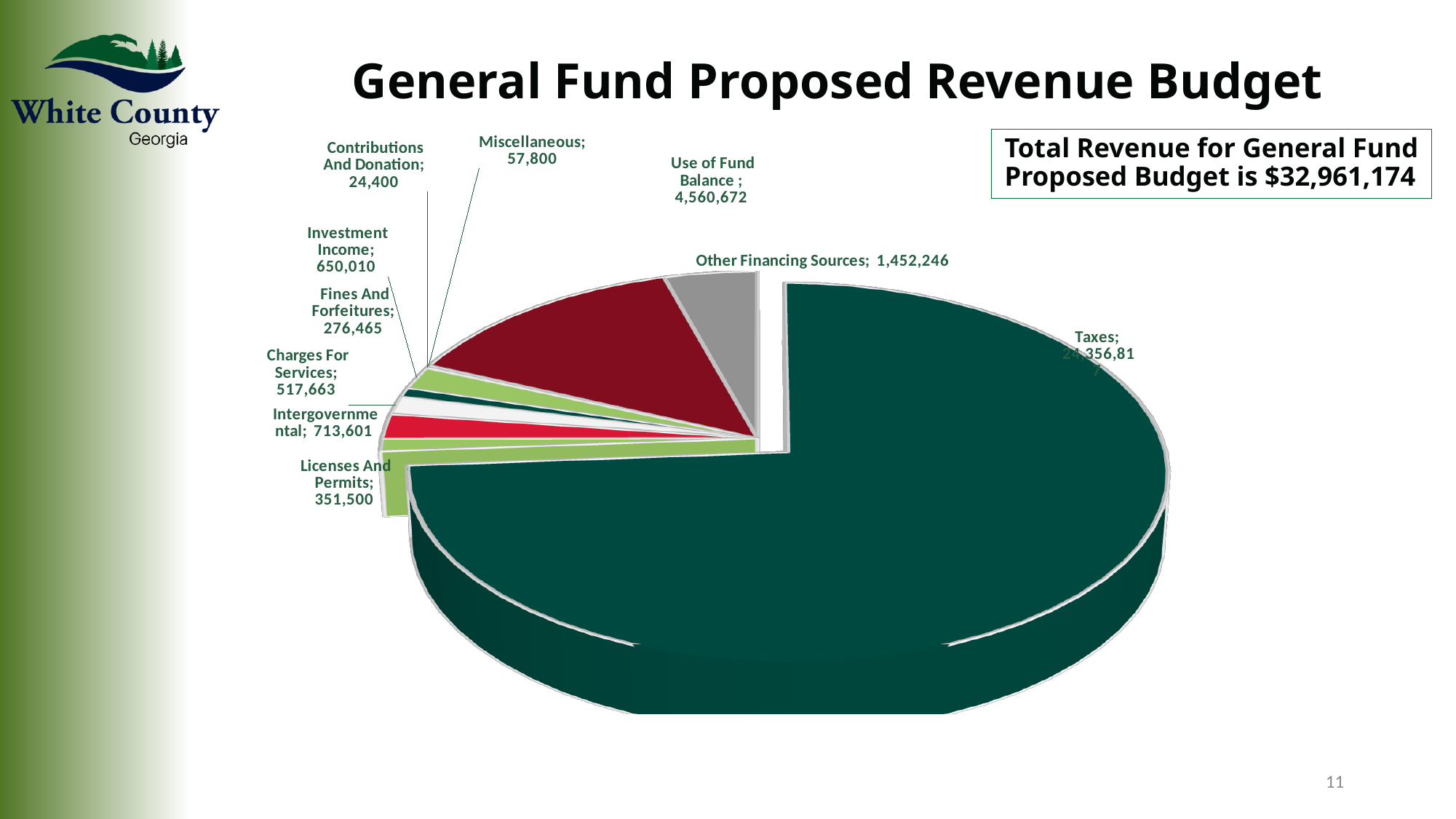
Which is larger, Licenses And Permits or Fines And Forfeitures? Licenses And Permits What is the value shown for Other Financing Sources? 1,452,246 According to the text box on the slide, what is the total revenue for the General Fund Proposed Budget? $32,961,174 What is the value shown for Intergovernmental? 713,601 Which revenue category is the largest slice of the pie chart? Taxes What type of chart is shown on the slide? Pie chart How many revenue categories are shown in the pie chart? 10 Which revenue category is the smallest slice of the pie chart? Contributions And Donation What is the difference between Use of Fund Balance and Other Financing Sources? 3,108,426 What is the value shown for Miscellaneous? 57,800 What is the value shown for Use of Fund Balance? 4,560,672 What is the title of the chart on the slide? General Fund Proposed Revenue Budget